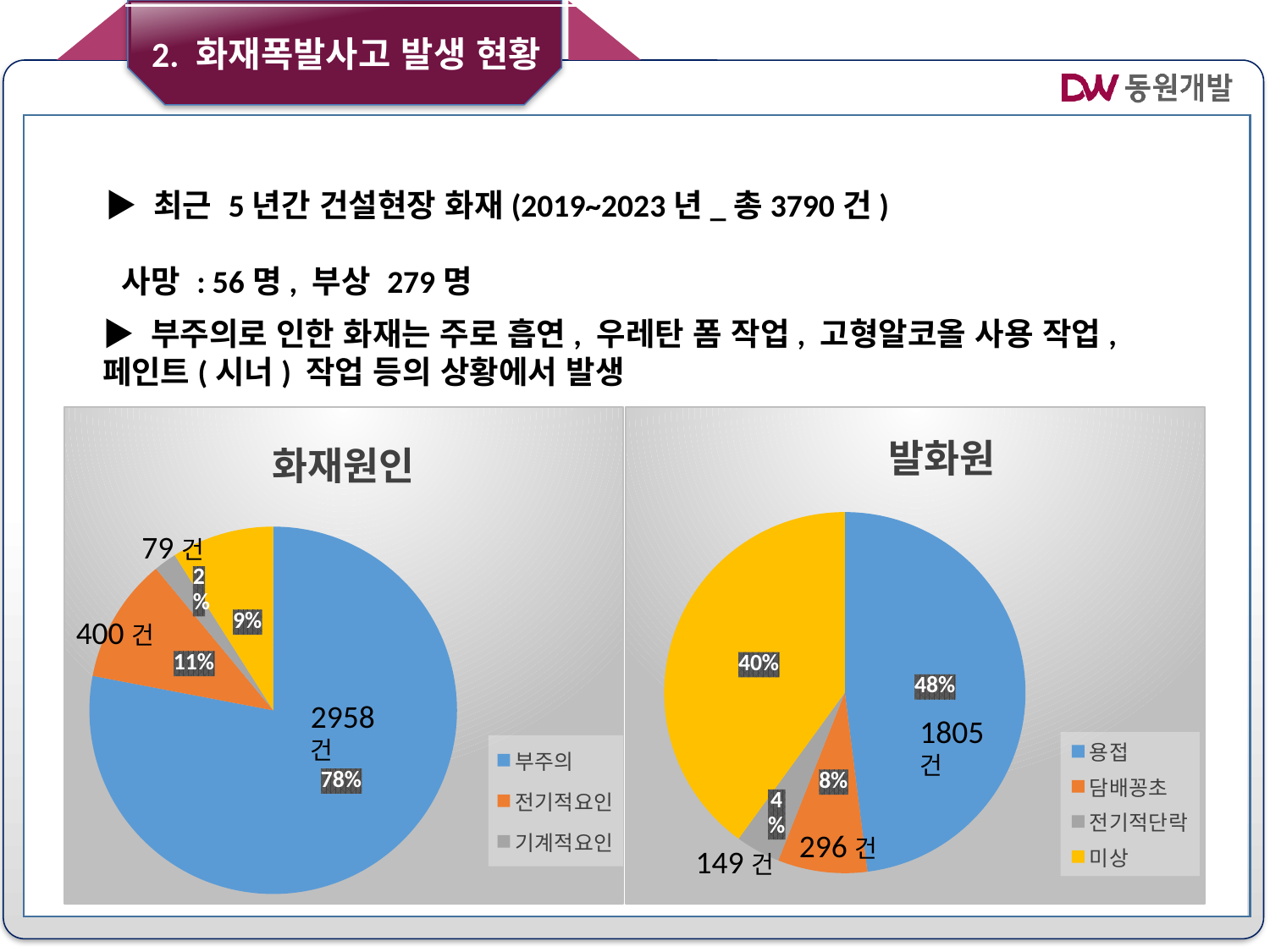
In the 화재원인 chart, what is the difference in cases between 부주의 and 전기적요인? 2558 건 In the 발화원 chart, what percentage share does 미상 have? 40% In the 화재원인 chart, how many cases are attributed to 기계적요인? 79 건 In the 발화원 chart, how many cases are attributed to 용접? 1805 건 In the 화재원인 chart, which category has the largest slice? 부주의 In the 화재원인 chart, how many cases are attributed to 부주의? 2958 건 In the 화재원인 chart, what percentage share does 전기적요인 have? 11% In the 발화원 chart, which is larger, 담배꽁초 or 전기적단락? 담배꽁초 In the 발화원 chart, which category has the smallest slice? 전기적단락 How many entries does the legend of the 발화원 chart list? 4 What type of chart is the 화재원인 chart? Pie chart In the 발화원 chart, how many cases are attributed to 담배꽁초? 296 건